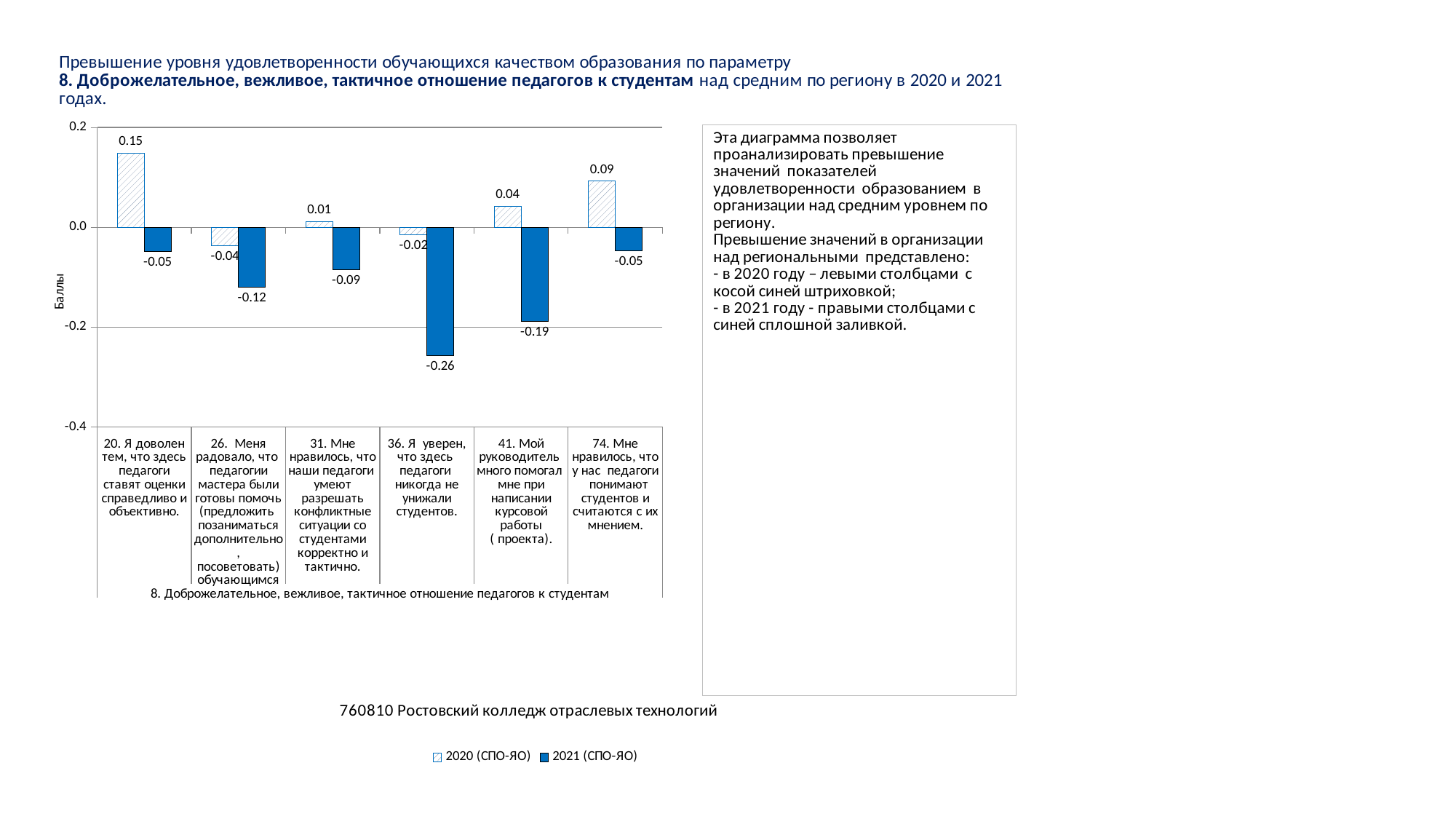
What is the label of the vertical axis of the chart? Баллы How many series does the legend list? 2 What kind of chart is shown on the slide? Bar chart What is the difference between the 2020 (СПО-ЯО) and 2021 (СПО-ЯО) values for category 20? 0.20 Which category has the lowest value for the 2021 (СПО-ЯО) series? 36. Я уверен, что здесь педагоги никогда не унижали студентов. What is the value for 2021 (СПО-ЯО) for category 41 (Мой руководитель много помогал мне при написании курсовой работы)? -0.19 How many categories are shown on the x axis of the chart? 6 Which is larger for category 26: the 2020 (СПО-ЯО) value or the 2021 (СПО-ЯО) value? 2020 (СПО-ЯО) Which category has the highest value for the 2020 (СПО-ЯО) series? 20. Я доволен тем, что здесь педагоги ставят оценки справедливо и объективно. What is the value for 2020 (СПО-ЯО) for category 74 (Мне нравилось, что у нас педагоги понимают студентов и считаются с их мнением)? 0.09 What is the value for 2021 (СПО-ЯО) for category 36 (Я уверен, что здесь педагоги никогда не унижали студентов)? -0.26 What is the value for 2020 (СПО-ЯО) for category 20 (Я доволен тем, что здесь педагоги ставят оценки справедливо и объективно)? 0.15